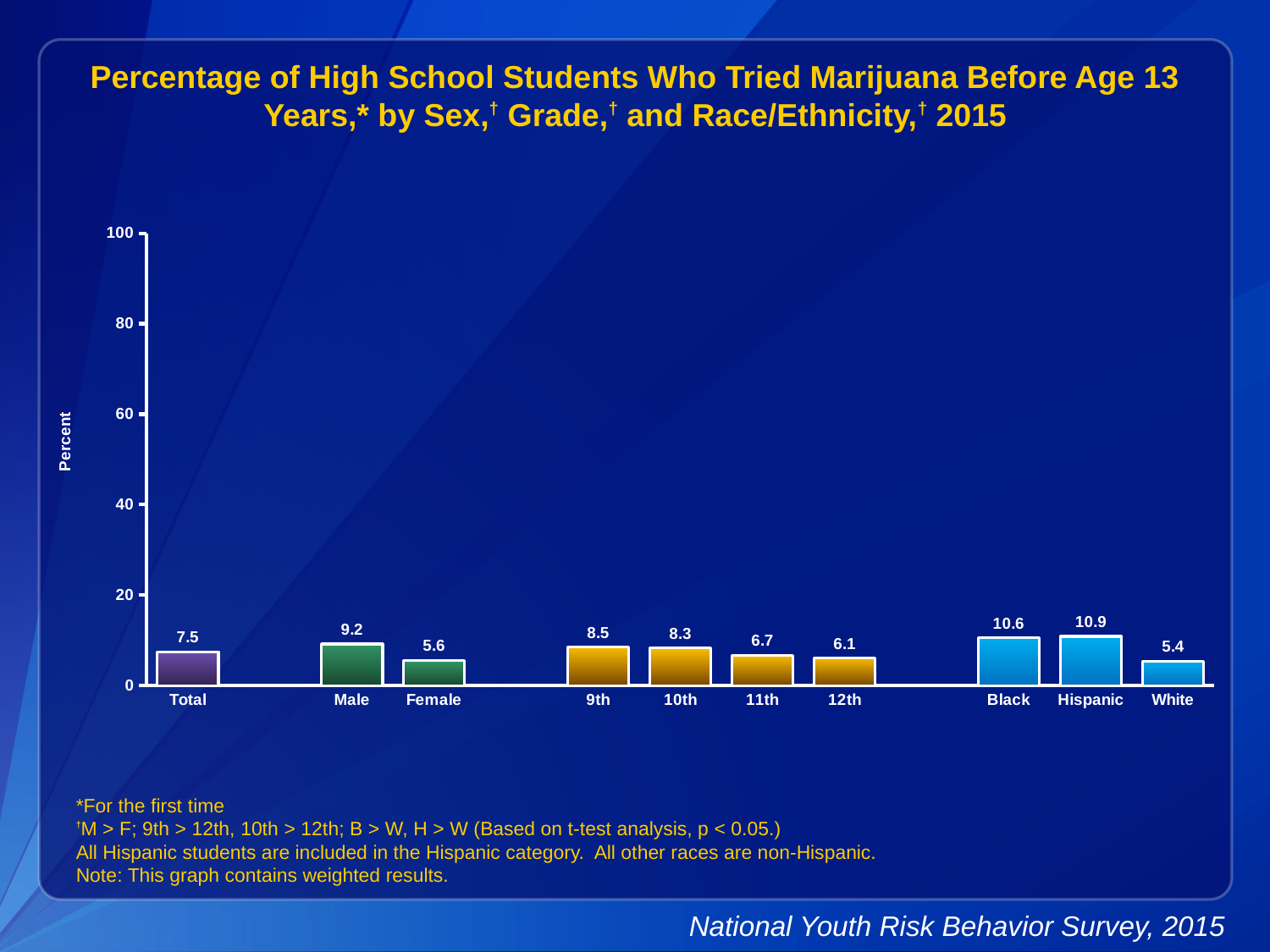
What is the value for Total? 7.5 What is the value for Male? 9.2 What is the value for 12th grade? 6.1 Which is larger, the value for 9th grade or the value for 11th grade? 9th What kind of chart is shown on the slide? bar chart How many categories are shown on the x axis? 10 What is the value for Hispanic? 10.9 Is the value for Black greater or less than 20? less Do the values rise or fall from 9th grade to 12th grade? fall Which category has the highest value? Hispanic What is the difference between the Male and Female values? 3.6 Which category has the lowest value? White